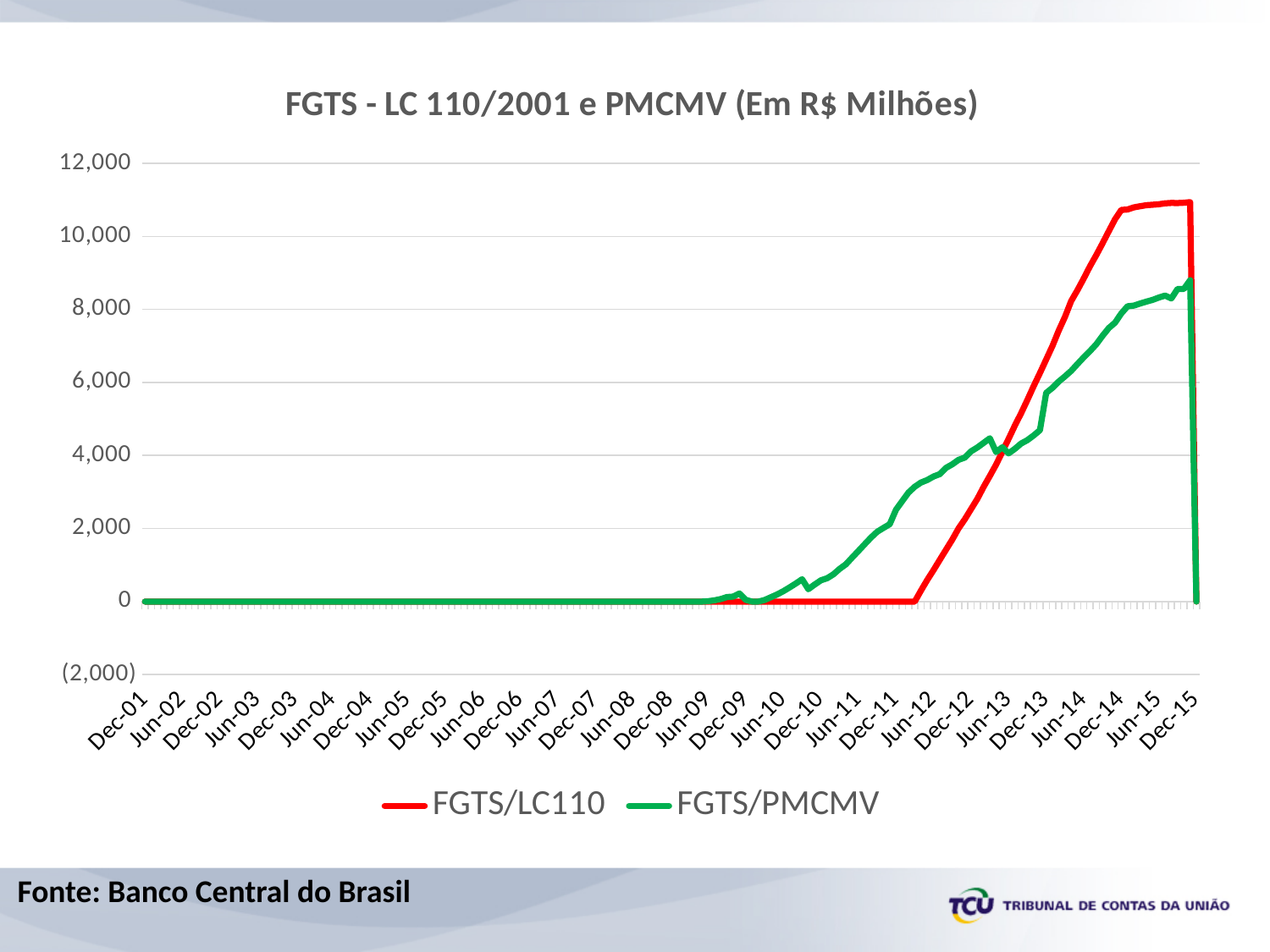
At Dec-11, which series has the larger value, FGTS/LC110 or FGTS/PMCMV? FGTS/PMCMV Is the value for FGTS/PMCMV at Jun-15 greater or less than 8,000? greater Is the value for FGTS/PMCMV at Dec-10 greater or less than 2,000? less What kind of chart is shown on the slide? line chart Which colour is used for the FGTS/PMCMV series? green Which series reaches the higher peak value on the chart? FGTS/LC110 Is the value for FGTS/LC110 at Jun-15 greater or less than 10,000? greater At Jun-15, which series has the larger value, FGTS/LC110 or FGTS/PMCMV? FGTS/LC110 How many series does the legend list? 2 What is the title of the chart? FGTS - LC 110/2001 e PMCMV (Em R$ Milhões) Does the FGTS/LC110 series rise or fall between Jun-12 and Jun-15? rise